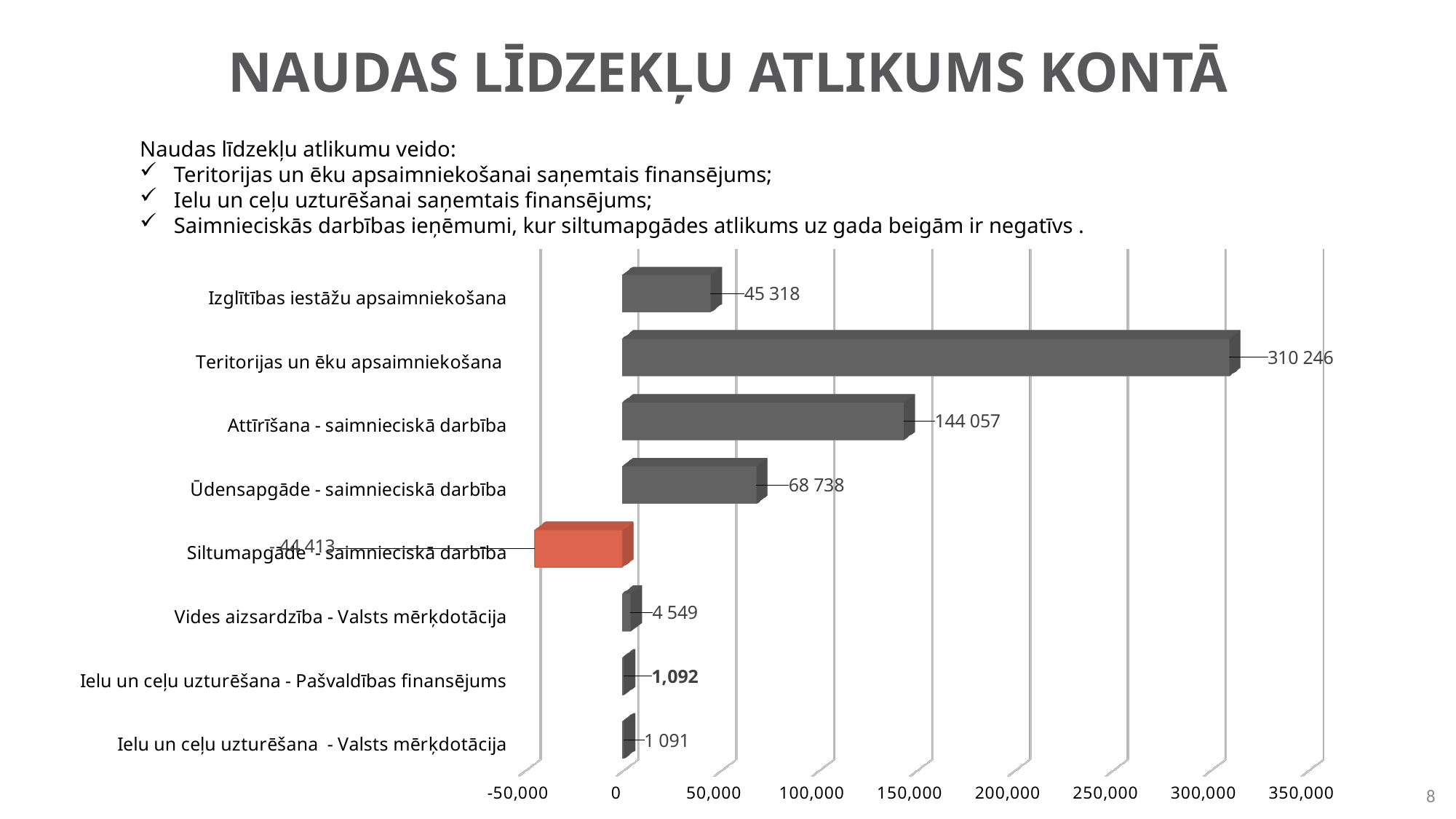
What is the value for Ūdensapgāde - saimnieciskā darbība? 68 738 What is the value for Izglītības iestāžu apsaimniekošana? 45 318 Which is larger, the value for Izglītības iestāžu apsaimniekošana or the value for Ūdensapgāde - saimnieciskā darbība? Ūdensapgāde - saimnieciskā darbība What is the difference between the values for Attīrīšana - saimnieciskā darbība and Ūdensapgāde - saimnieciskā darbība? 75 319 What is the value for Vides aizsardzība - Valsts mērķdotācija? 4 549 What kind of chart is shown on the slide? bar chart Is the value for Siltumapgāde - saimnieciskā darbība greater or less than 0? less Which category has the highest value? Teritorijas un ēku apsaimniekošana What is the value for Teritorijas un ēku apsaimniekošana? 310 246 What is the value for Attīrīšana - saimnieciskā darbība? 144 057 How many categories are shown in the chart? 8 Which category has the lowest value? Siltumapgāde - saimnieciskā darbība